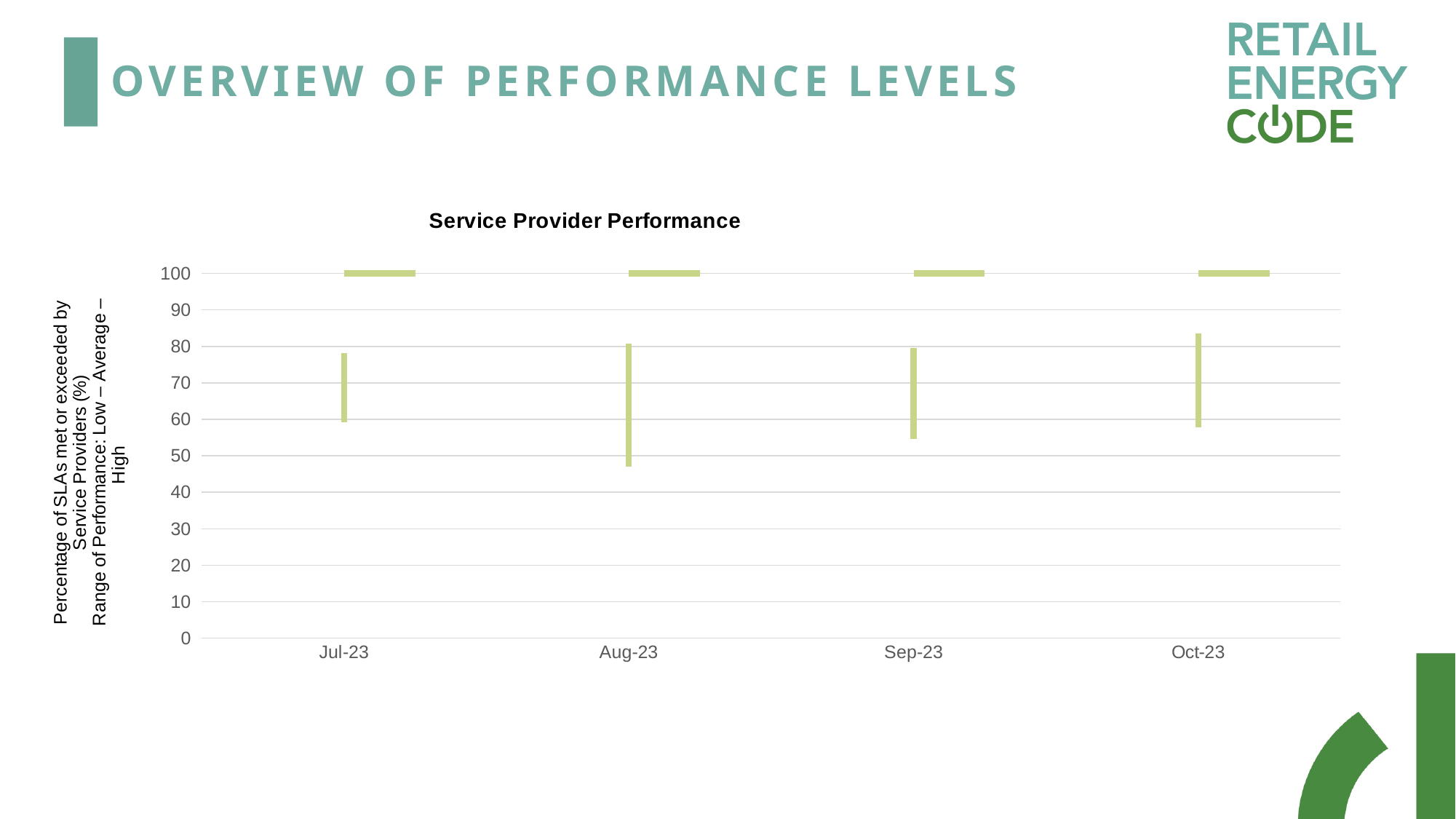
What is the first month shown on the x axis? Jul-23 What is the title of the chart? Service Provider Performance Is the bottom of the Aug-23 range greater or less than 50? less What is the highest tick value shown on the y axis? 100 Which is larger, the bottom of the Jul-23 range or the bottom of the Aug-23 range? Jul-23 Is the bottom of the Jul-23 range greater or less than 50? greater Is the bottom of the Oct-23 range greater or less than 50? greater How many months are shown on the x axis of the chart? 4 Which month has the lowest bottom of its performance range? Aug-23 What kind of chart is shown on the slide? High-low range (stock) chart What value does the top marker reach for every month on the chart? 100